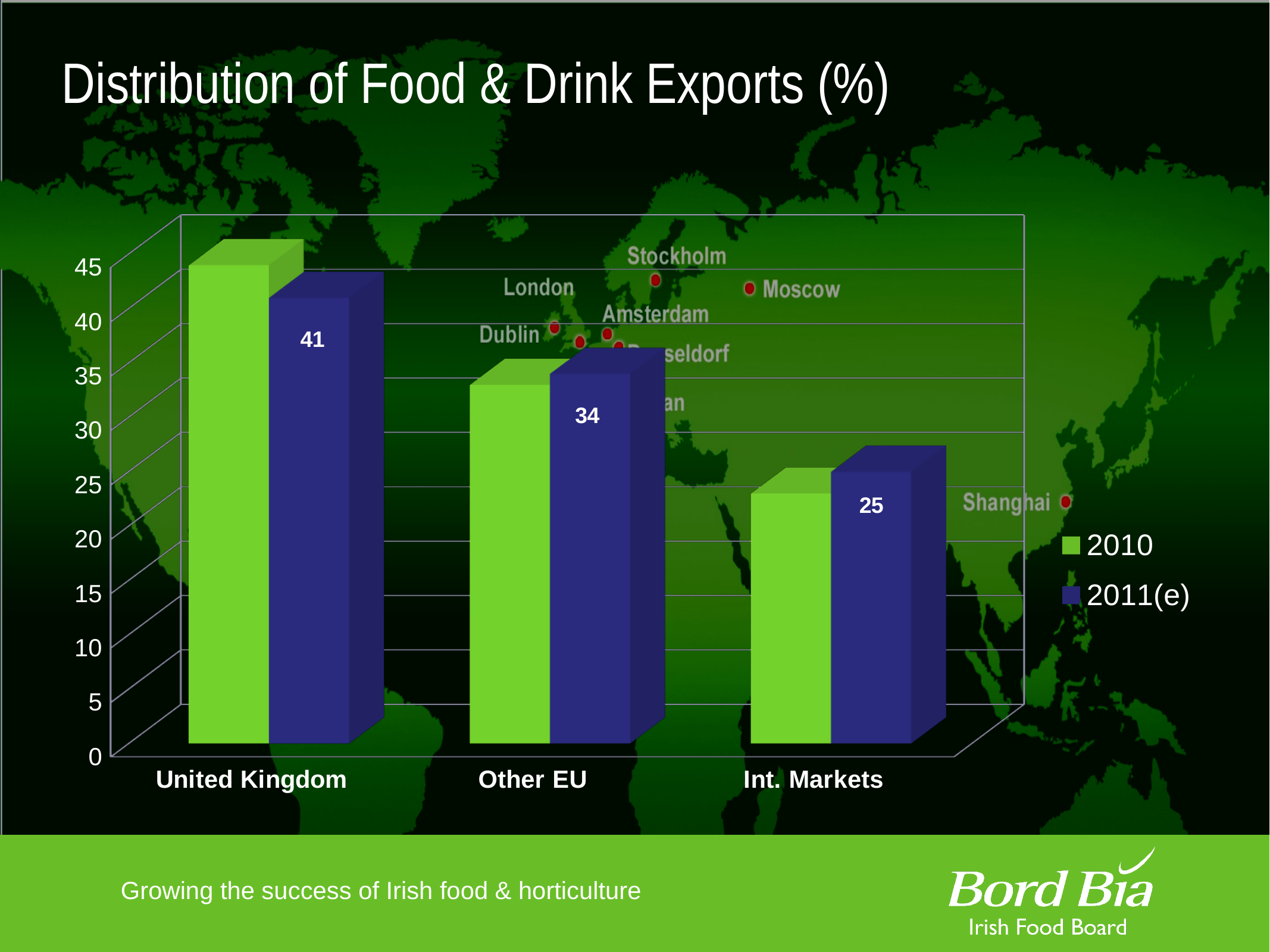
What is the 2011(e) value for Int. Markets? 25 Which category has the highest 2011(e) value? United Kingdom What is the 2011(e) value for Other EU? 34 What is the difference between the 2011(e) values for United Kingdom and Int. Markets? 16 What is the difference between the 2011(e) values for United Kingdom and Other EU? 7 Which category has the lowest 2011(e) value? Int. Markets For United Kingdom, which is larger: the 2010 value or the 2011(e) value? 2010 What is the 2011(e) value for United Kingdom? 41 Is the 2010 value for Int. Markets greater or less than 30? less Is the 2010 value for United Kingdom greater or less than 40? greater How many categories are shown on the x axis? 3 How many series does the legend list? 2